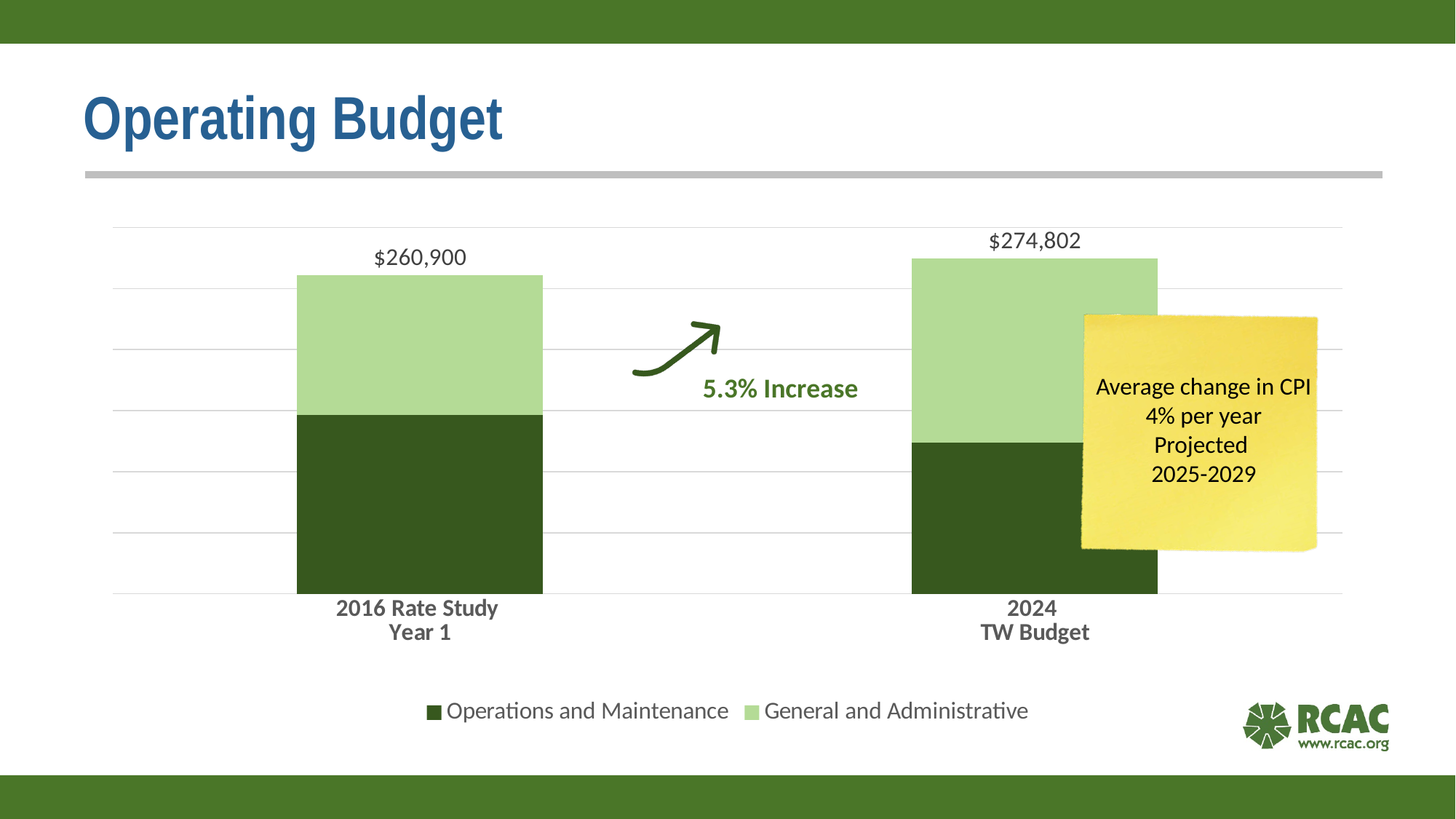
What is the difference between the 2024 TW Budget total and the 2016 Rate Study Year 1 total? $13,902 Is the total for 2024 TW Budget larger or smaller than the total for 2016 Rate Study Year 1? larger What percentage increase is annotated between the two bars? 5.3% Increase Which category has the lower total operating budget? 2016 Rate Study Year 1 How many series does the legend list? 2 How many categories are plotted on the x axis? 2 What kind of chart is shown on the slide? Stacked bar chart Do the total values rise or fall from 2016 Rate Study Year 1 to 2024 TW Budget? rise What is the total operating budget shown for 2016 Rate Study Year 1? $260,900 Which series is shown in dark green in the legend? Operations and Maintenance Which category has the higher total operating budget? 2024 TW Budget What is the total operating budget shown for 2024 TW Budget? $274,802